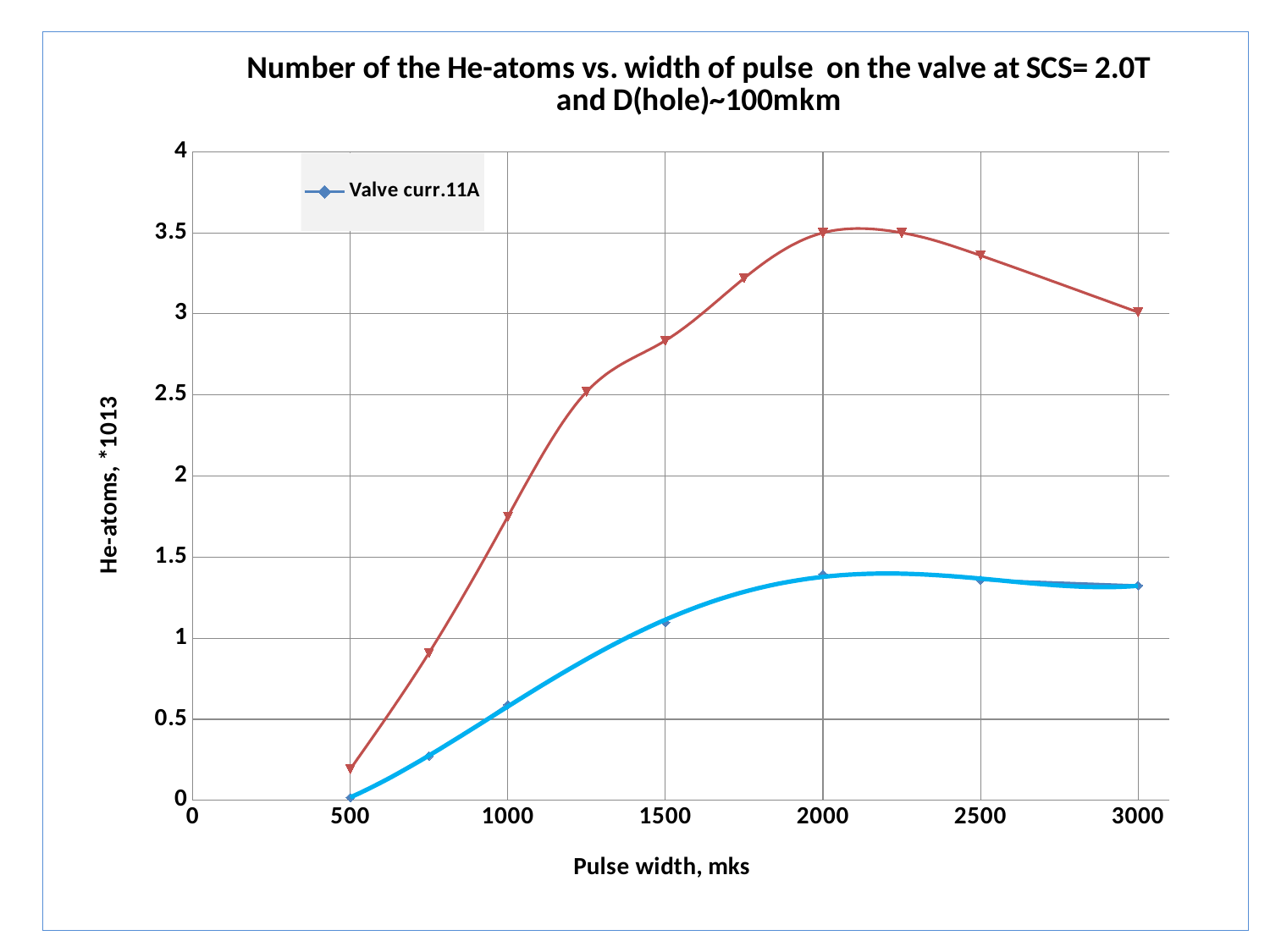
Is the value for Valve curr.11A at a pulse width of 2000 greater or less than 1? greater Does the Valve curr.11A series rise or fall as the pulse width increases from 500 to 2000? rise How many series does the legend list? 1 Is the value for Valve curr.11A at a pulse width of 1000 greater or less than 1? less For Valve curr.11A, which is larger: the value at a pulse width of 1000 or at 1500? 1500 What is the title of the x axis? Pulse width, mks Is the value for Valve curr.11A at a pulse width of 1500 greater or less than 1.5? less How many data points are plotted for the Valve curr.11A series? 7 What kind of chart is shown on the slide? line chart What is the name of the series listed in the legend? Valve curr.11A At which pulse width is the value for Valve curr.11A lowest? 500